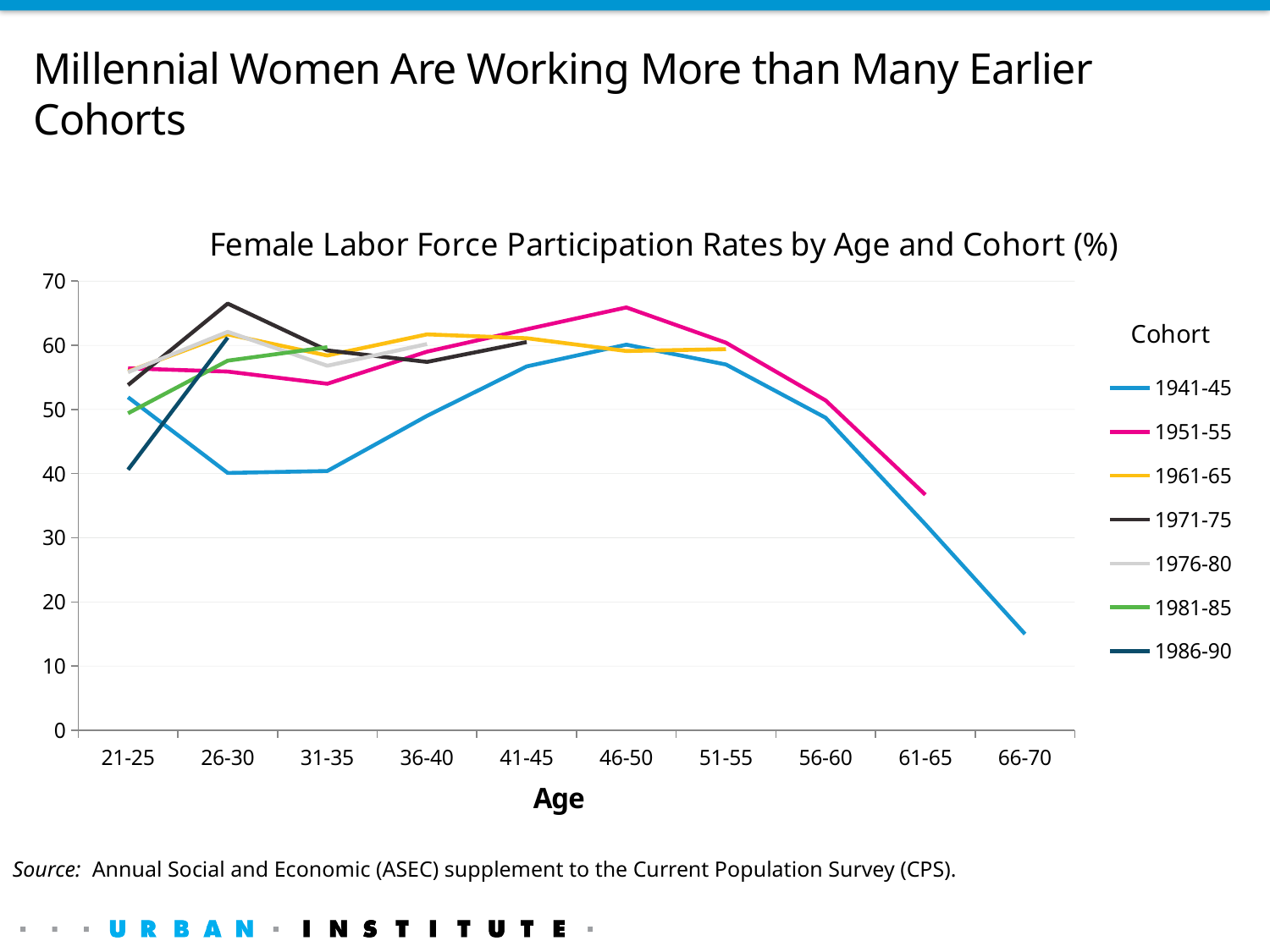
Is the value for the 1971-75 cohort at age 26-30 greater or less than 60? greater Is the value for the 1986-90 cohort at age 21-25 greater or less than 50? less At age 26-30, which cohort has the higher participation rate, 1941-45 or 1971-75? 1971-75 Does the 1941-45 cohort's participation rate rise or fall from age 46-50 to age 66-70? fall How many cohorts does the legend list? 7 Which cohort has the highest participation rate at age 26-30? 1971-75 Which cohort has the lowest participation rate at age 21-25? 1986-90 How many age groups are shown on the x axis? 10 What kind of chart is shown on the slide? line chart Is the value for the 1941-45 cohort at age 66-70 greater or less than 20? less What is the title of the x axis? Age